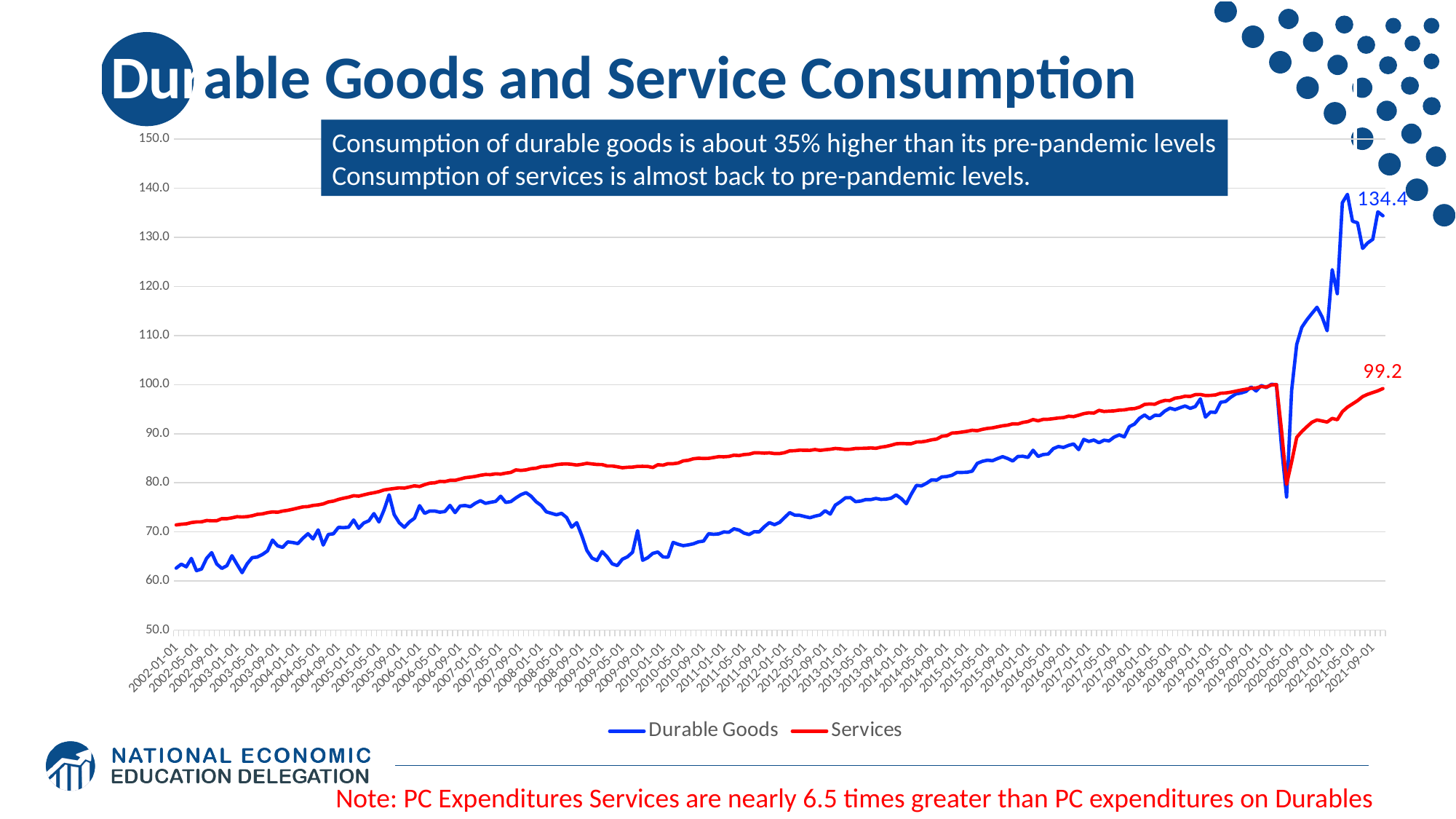
Is the value for Services at 2002-01-01 greater or less than 80? less How many series does the legend list? 2 What is the final labelled value of the Durable Goods series? 134.4 Is the value for Services at its 2020 dip greater or less than 90? less What is the final labelled value of the Services series? 99.2 Is the value for Durable Goods at 2002-01-01 greater or less than 70? less What kind of chart is shown on the slide? line chart Which series is higher for most of the period before 2020: Durable Goods or Services? Services What colour is the Services line? red What is the difference between the final labelled values of Durable Goods (134.4) and Services (99.2)? 35.2 At the end of the series, which is higher: Durable Goods or Services? Durable Goods Does the Services line generally rise or fall from 2002 to 2019? rise